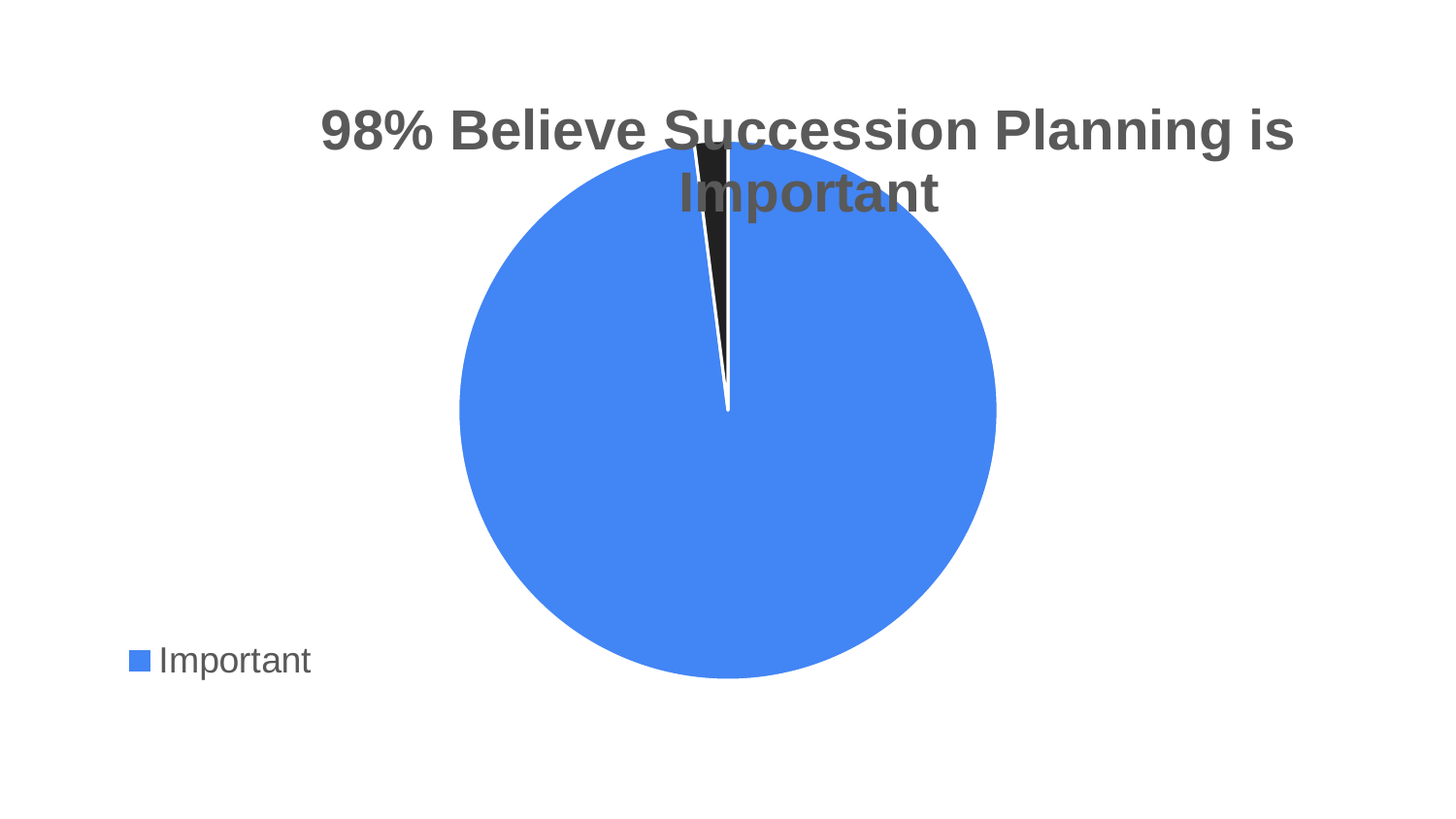
According to the slide, what share of the pie does the 'Important' slice represent? 98% Is the 'Important' slice larger or smaller than the black slice? larger How many entries does the chart's legend list? 1 Which slice of the pie is the largest? Important What is the title of the chart? 98% Believe Succession Planning is Important How many slices does the pie chart have? 2 What is the only category named in the legend? Important Is the share for 'Important' greater or less than 50%? greater What kind of chart is shown on the slide? pie chart